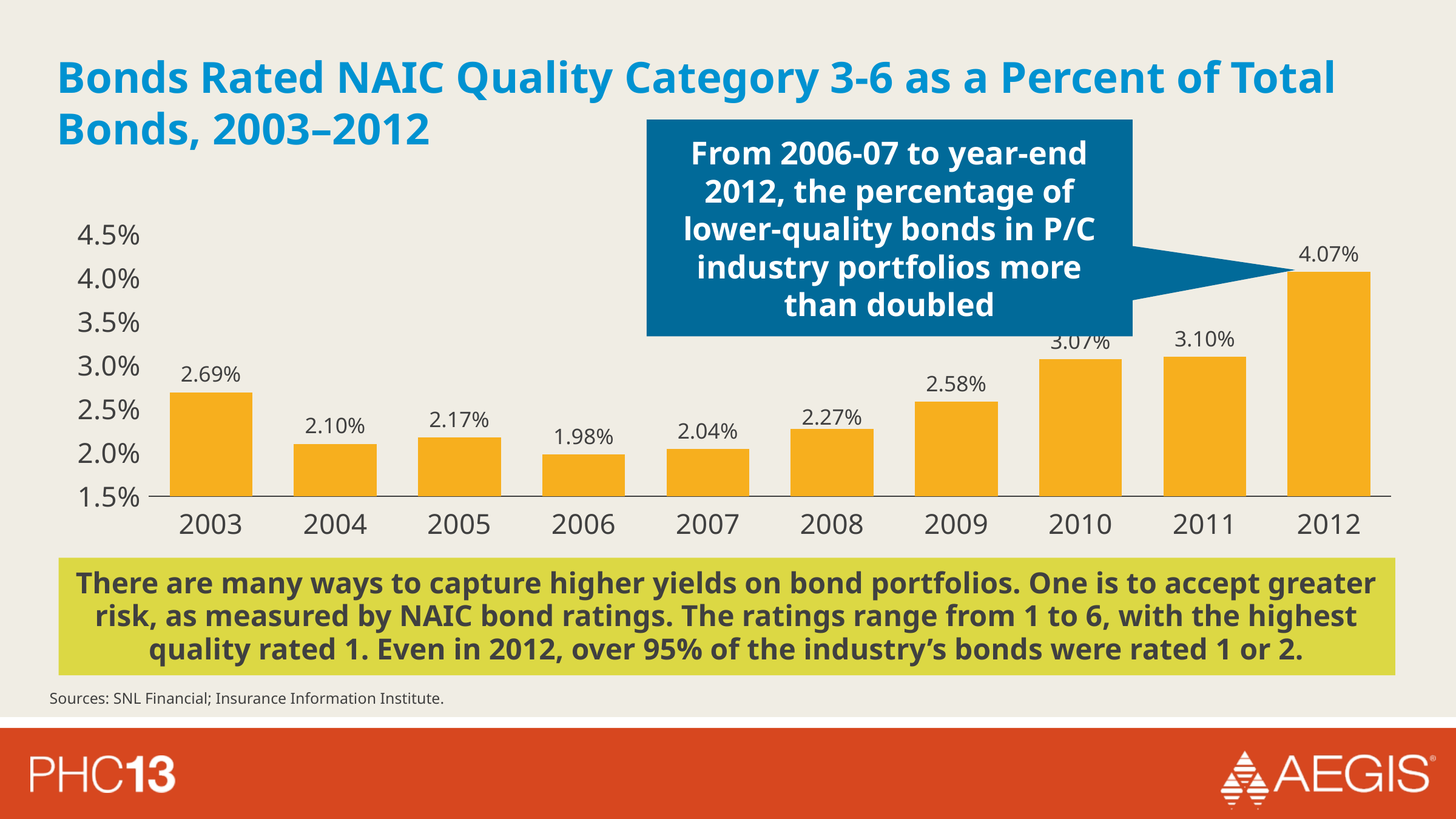
Which year has the highest value? 2012 What is the value for 2012? 4.07% What is the difference between the values for 2012 and 2006? 2.09% Do the values rise or fall from 2007 to 2012? rise How many years are shown on the x axis? 10 What is the value for 2003? 2.69% What is the title of the chart? Bonds Rated NAIC Quality Category 3-6 as a Percent of Total Bonds, 2003–2012 Which year has the lowest value? 2006 Which is larger, the value for 2003 or the value for 2009? 2003 What kind of chart is shown on the slide? bar chart What is the value for 2006? 1.98% Is the value for 2010 greater or less than 3.5%? less